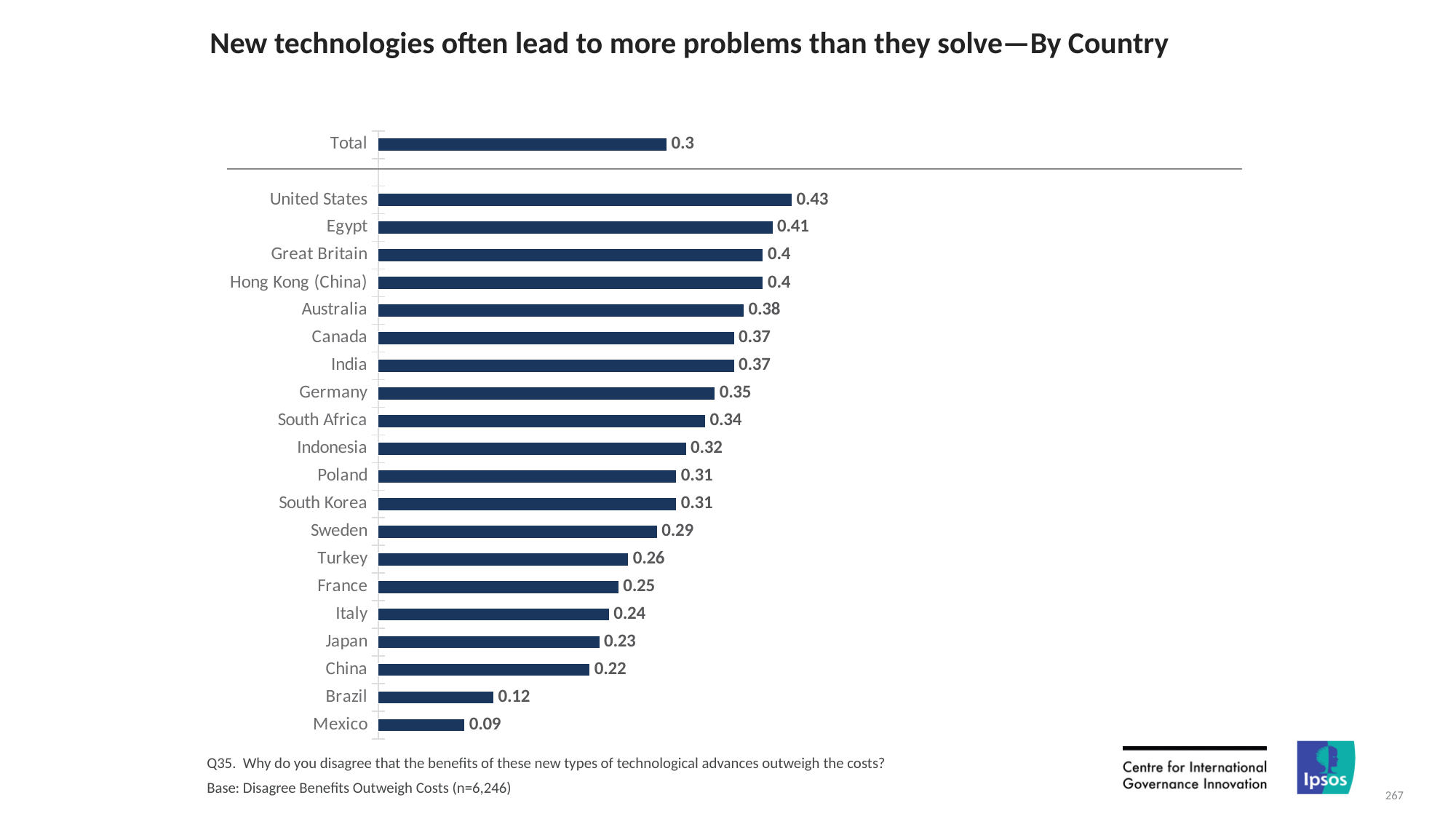
What is the value for Total? 0.3 What is the value for the United States? 0.43 Which country has the lowest value? Mexico Which has a larger value, Australia or Turkey? Australia What is the value for Sweden? 0.29 What kind of chart is shown on the slide? Bar chart How many countries are listed on the chart, excluding Total? 19 Which country has the highest value? United States What is the difference between the values for Egypt and Germany? 0.06 What is the title of the chart? New technologies often lead to more problems than they solve—By Country What is the value for Brazil? 0.12 What is the difference between the values for the United States and Mexico? 0.34